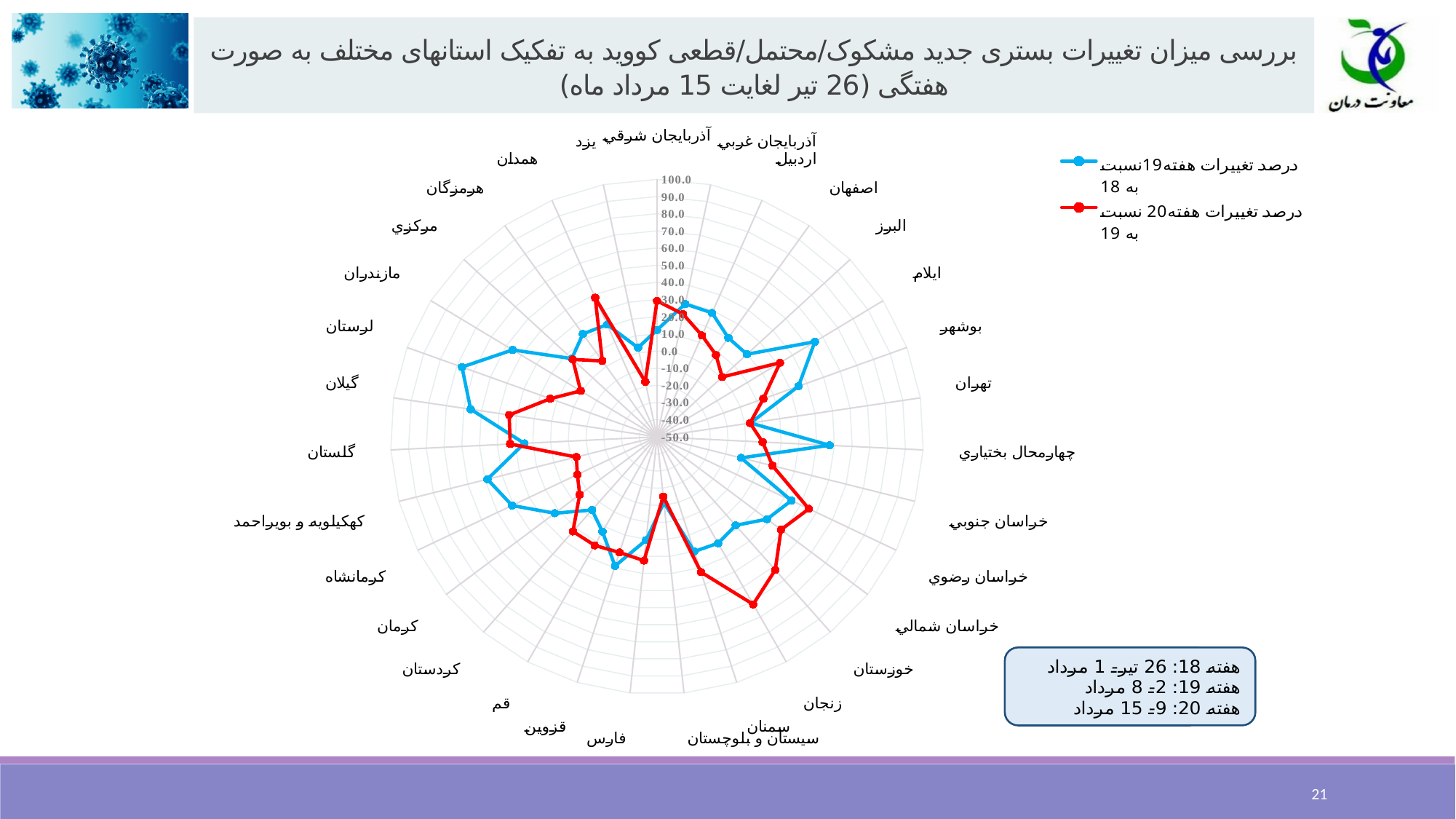
For خراسان شمالي, which series has the larger value: 'درصد تغييرات هفته19نسبت به 18' or 'درصد تغييرات هفته20 نسبت به 19'? درصد تغييرات هفته20 نسبت به 19 Is the value for گيلان in the series 'درصد تغييرات هفته19نسبت به 18' greater or less than 60? less Is the value for بوشهر in the series 'درصد تغييرات هفته19نسبت به 18' greater or less than 30? greater What kind of chart is shown on the slide? Radar chart What is the lowest value shown on the radial axis of the chart? -50.0 Is the value for چهارمحال بختياري in the series 'درصد تغييرات هفته19نسبت به 18' greater or less than 20? greater How many provinces (categories) are plotted around the radar chart? 31 How many series does the legend list? 2 For چهارمحال بختياري, which series has the larger value: 'درصد تغييرات هفته19نسبت به 18' or 'درصد تغييرات هفته20 نسبت به 19'? درصد تغييرات هفته19نسبت به 18 What is the highest value shown on the radial axis of the chart? 100.0